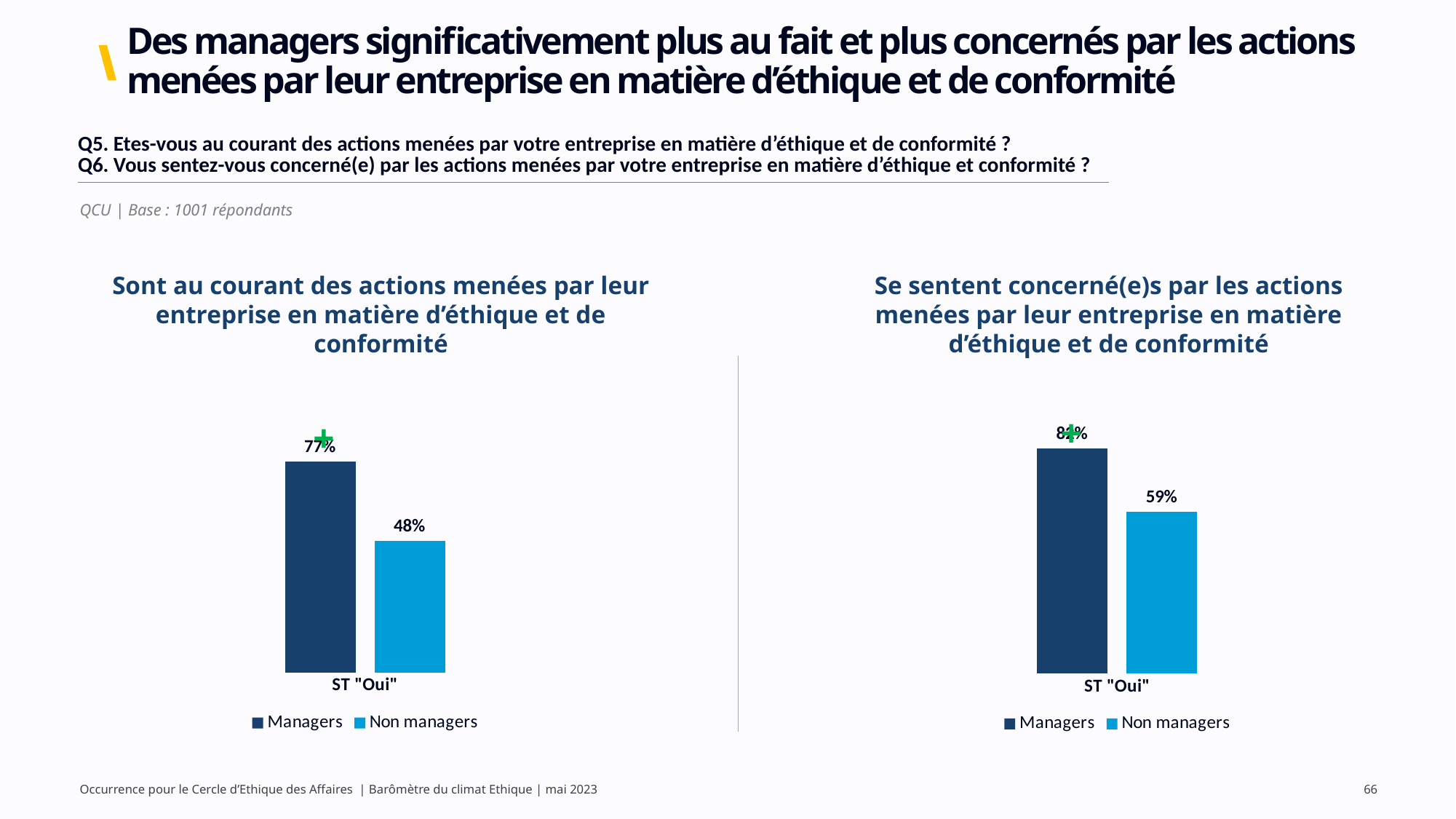
In the left chart ("Sont au courant des actions menées par leur entreprise..."), what is the difference between the Managers and Non managers values? 29 percentage points In the right chart ("Se sentent concerné(e)s par les actions menées..."), which series has the lowest value? Non managers What is the category label on the x axis of the right chart? ST "Oui" In the left chart ("Sont au courant des actions menées par leur entreprise..."), what is the value for Managers? 77% In the left chart, which series is drawn in dark navy blue? Managers In the right chart ("Se sentent concerné(e)s par les actions menées..."), which series has the higher value, Managers or Non managers? Managers In the left chart ("Sont au courant des actions menées par leur entreprise..."), which series has the higher value, Managers or Non managers? Managers What kind of chart is the right chart ("Se sentent concerné(e)s par les actions menées...")? Bar chart How many categories are shown on the x axis of the left chart? 1 In the right chart ("Se sentent concerné(e)s par les actions menées..."), what is the value for Non managers? 59% In the left chart ("Sont au courant des actions menées par leur entreprise..."), what is the value for Non managers? 48% How many series does the legend of the left chart list? 2